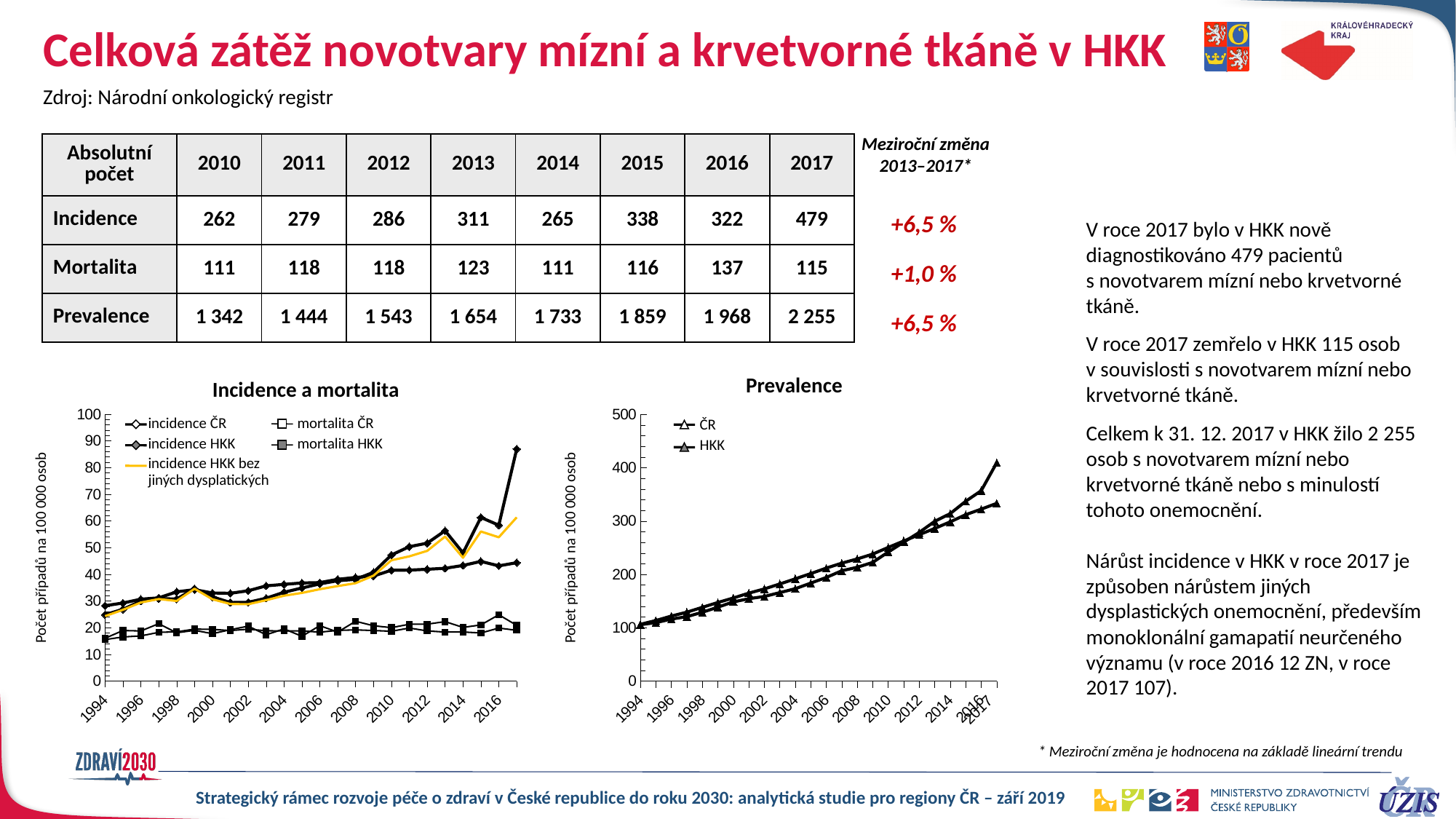
In the 'Incidence a mortalita' chart, is the value for mortalita HKK in 2016 greater or less than 30? less In the 'Incidence a mortalita' chart, is the value for incidence HKK in 2016 greater or less than 80? less What kind of chart is the 'Prevalence' chart? line chart How many series does the legend of the 'Prevalence' chart list? 2 In the 'Prevalence' chart, is the value for ČR in 2017 greater or less than 400? less What is the y-axis label of the 'Prevalence' chart? Počet případů na 100 000 osob In the 'Prevalence' chart, which series has the higher value in 2017, ČR or HKK? HKK What kind of chart is the 'Incidence a mortalita' chart? line chart In the 'Prevalence' chart, do the values rise or fall from 1994 to 2017? rise How many series does the legend of the 'Incidence a mortalita' chart list? 5